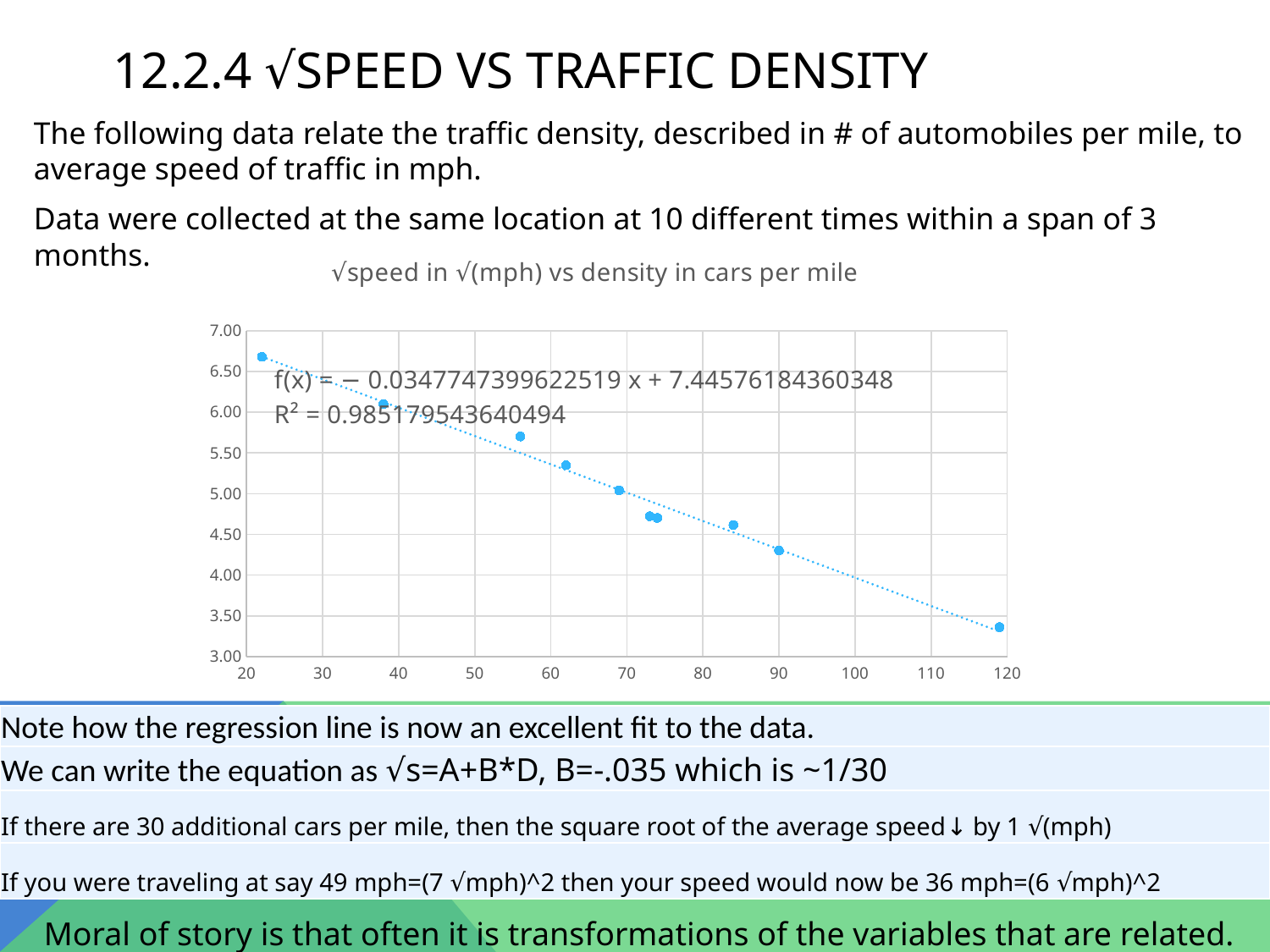
How many data points are plotted on the chart? 10 What is the title of the chart? √speed in √(mph) vs density in cars per mile Is the √speed value for the point at the highest density (around 119 cars per mile) greater or less than 3.50? less What R² value is printed on the chart for the trendline? 0.985179543640494 Which point has a larger √speed value: the one at a density of about 22 or the one at a density of about 119? the one at about 22 Does the point with the highest √speed occur at the lowest density or the highest density? lowest density Is the √speed value for the point at the lowest density (around 22 cars per mile) greater or less than 6.50? greater Is the √speed value for the point at a density of about 62 cars per mile greater or less than 5.50? less What kind of chart is shown on the slide? scatter chart As density (the x axis) increases, does √speed rise or fall? fall